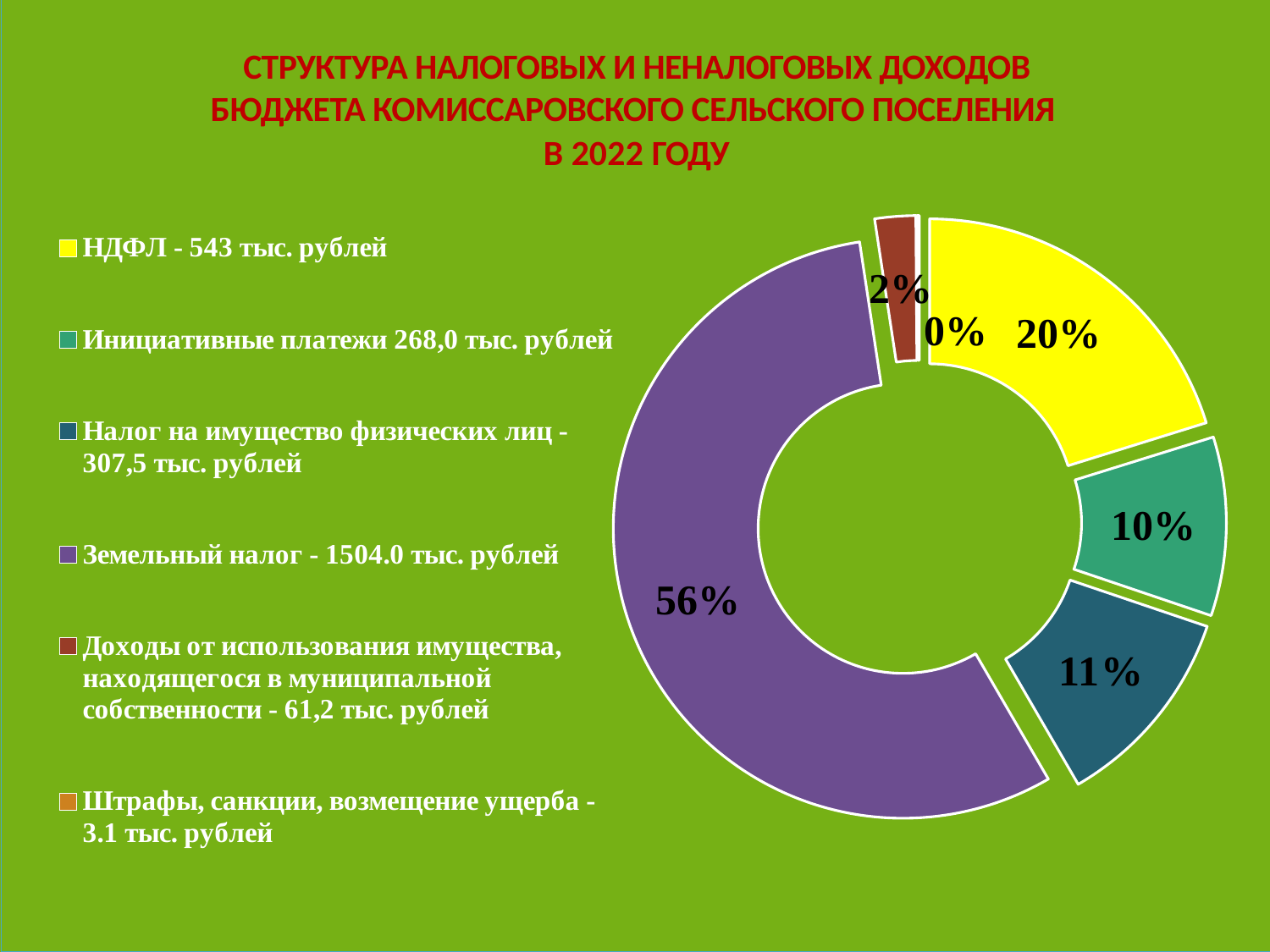
What share of the chart do Доходы от использования имущества, находящегося в муниципальной собственности take? 2% What share of the chart does Налог на имущество физических лиц take? 11% What share of the chart does Земельный налог take? 56% According to the legend, what is the amount for Земельный налог? 1504.0 тыс. рублей What is the difference in percentage points between the share of Земельный налог and the share of НДФЛ? 36 percentage points Which category has the largest share of the chart? Земельный налог How many categories does the legend list? 6 Which has the larger share: Налог на имущество физических лиц or Инициативные платежи? Налог на имущество физических лиц Which category has the smallest share of the chart? Штрафы, санкции, возмещение ущерба What kind of chart is shown on the slide? Doughnut (pie) chart